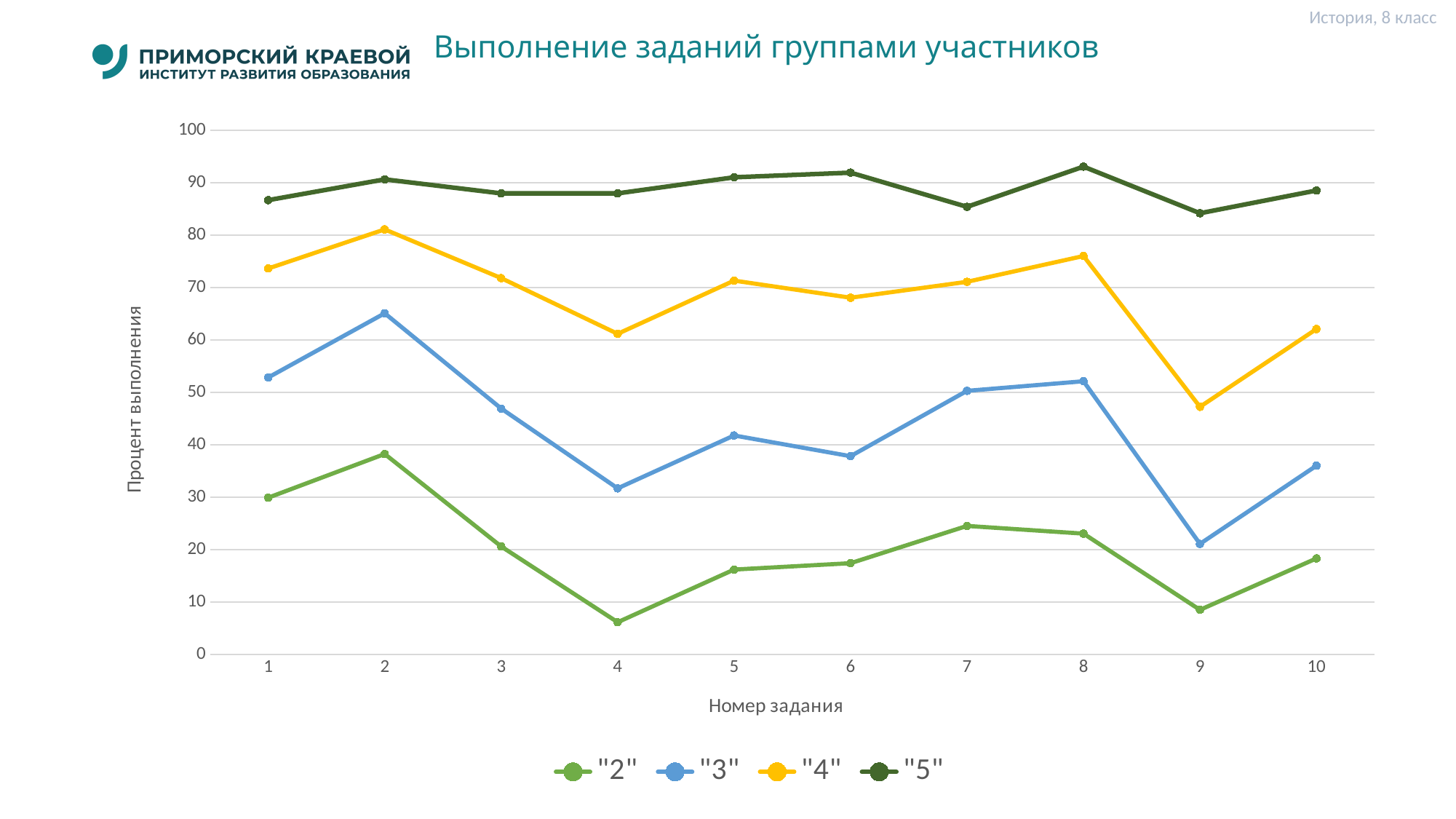
Is the value for the "3" series at task 4 greater or less than 40? less Does the "2" series rise or fall from task 2 to task 4? fall For the "5" series, which is larger: the value at task 8 or the value at task 9? task 8 For which task number does the "4" series reach its lowest value? 9 Is the value for the "4" series at task 9 greater or less than 50? less How many series does the legend list? 4 How many task numbers are shown on the x axis? 10 For which task number does the "2" series reach its highest value? 2 What kind of chart is shown on the slide? line chart For which task number does the "3" series reach its highest value? 2 For which task number does the "2" series reach its lowest value? 4 For which task number does the "3" series reach its lowest value? 9